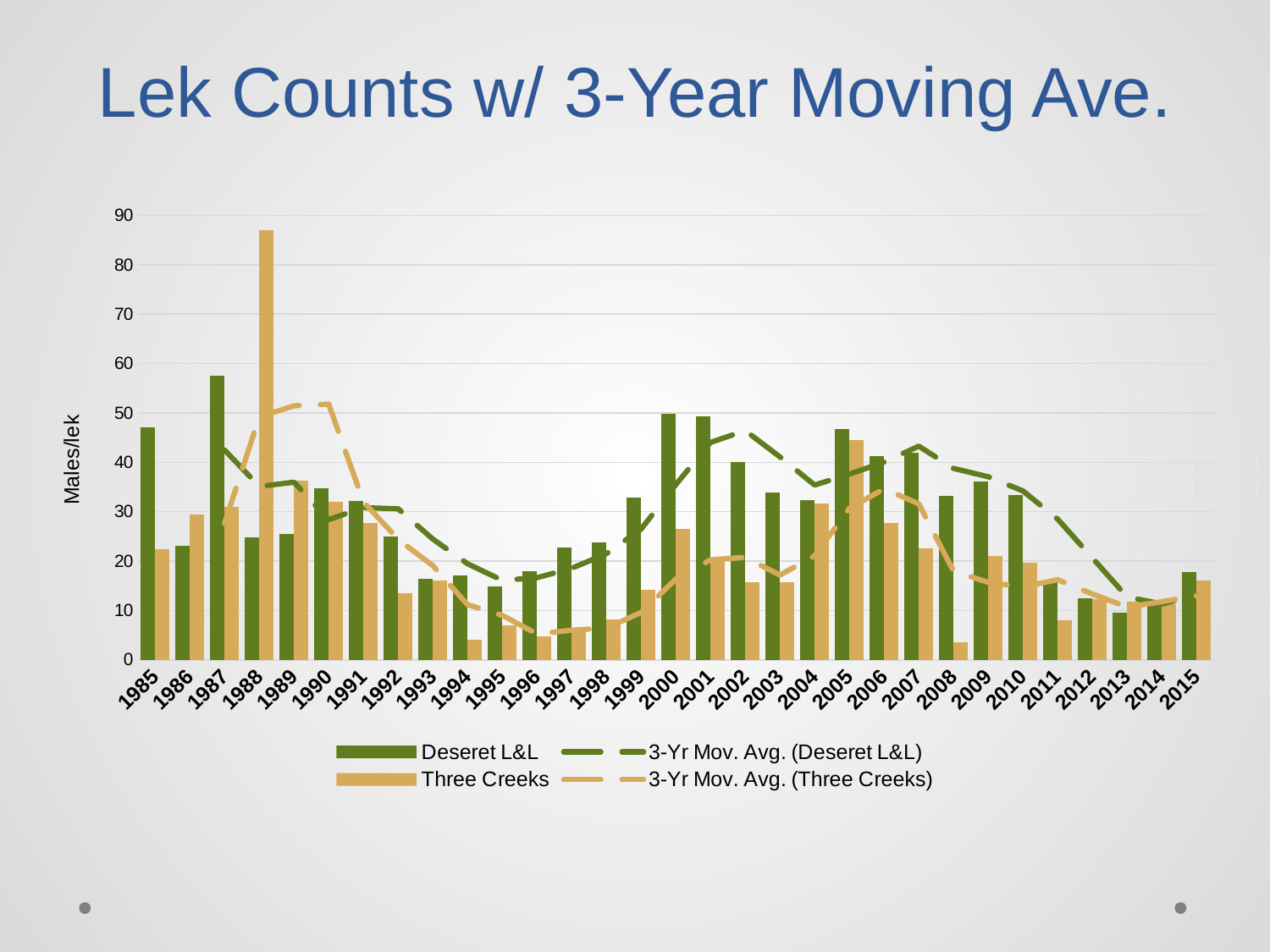
In 2000, which series has the larger value, Deseret L&L or Three Creeks? Deseret L&L Do the Deseret L&L bars rise or fall from 2007 to 2013? fall Is the Deseret L&L value for 1993 greater or less than 20? less What kind of chart is shown on the slide? Bar chart with moving-average lines In which year is the Three Creeks bar highest? 1988 What is the label on the vertical axis? Males/lek How many series does the legend list? 4 Is the Three Creeks value for 1988 greater or less than 80? greater In which year is the Deseret L&L bar highest? 1987 Is the Deseret L&L value for 1985 greater or less than 40? greater How many years are shown along the x axis? 31